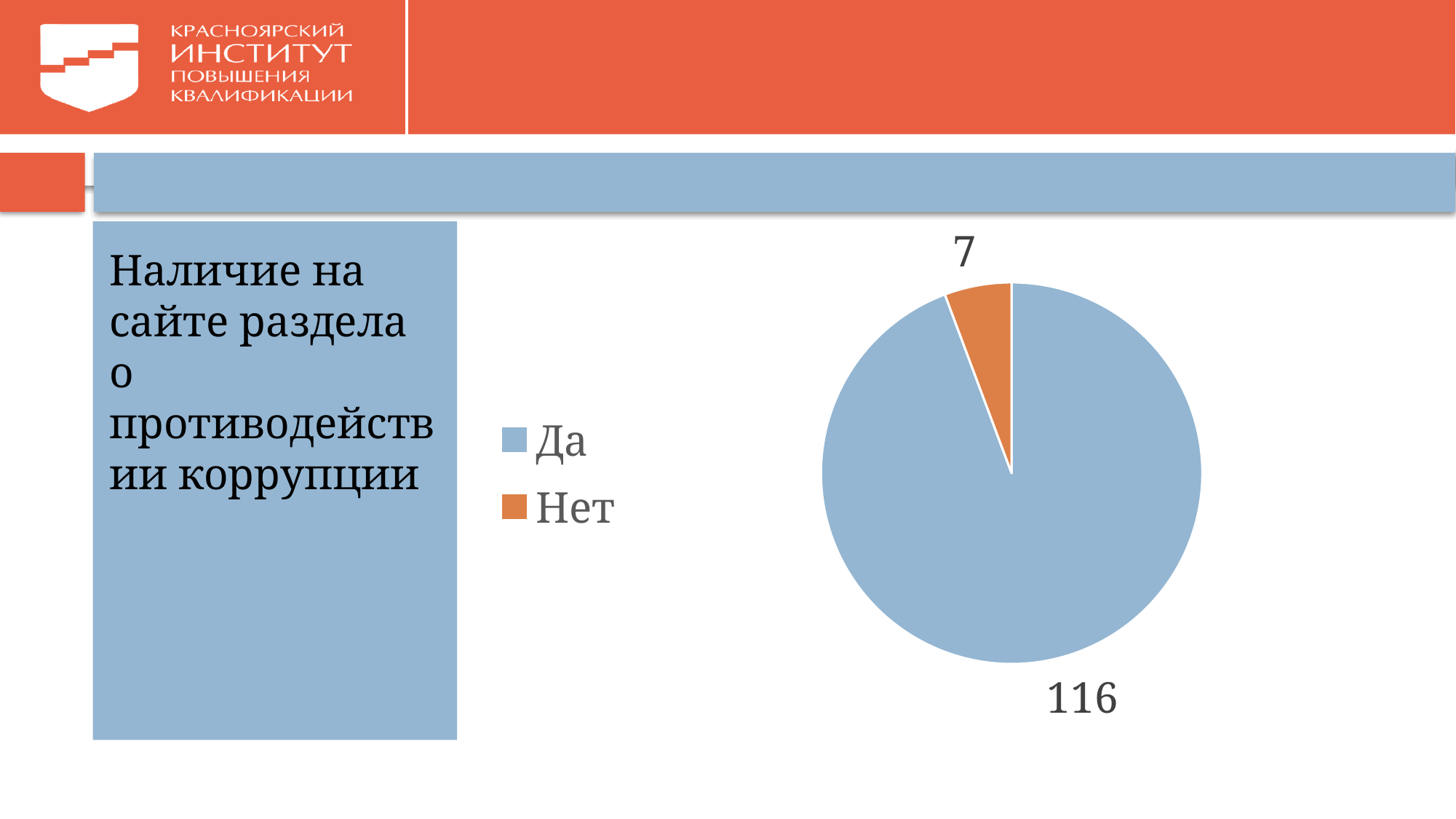
Which category has the smallest slice in the pie chart? Нет What fraction of the pie chart total does the "Да" slice represent? 116/123 What is the value for the "Да" slice of the pie chart? 116 How many slices does the pie chart have? 2 What is the value for the "Нет" slice of the pie chart? 7 What is the difference between the "Да" and "Нет" values in the pie chart? 109 What is the total of all slices in the pie chart? 123 Which is larger in the pie chart, "Да" or "Нет"? Да Which category has the largest slice in the pie chart? Да What type of chart is shown on the slide? pie chart What colour is the "Нет" slice in the pie chart? orange How many entries does the legend of the pie chart list? 2